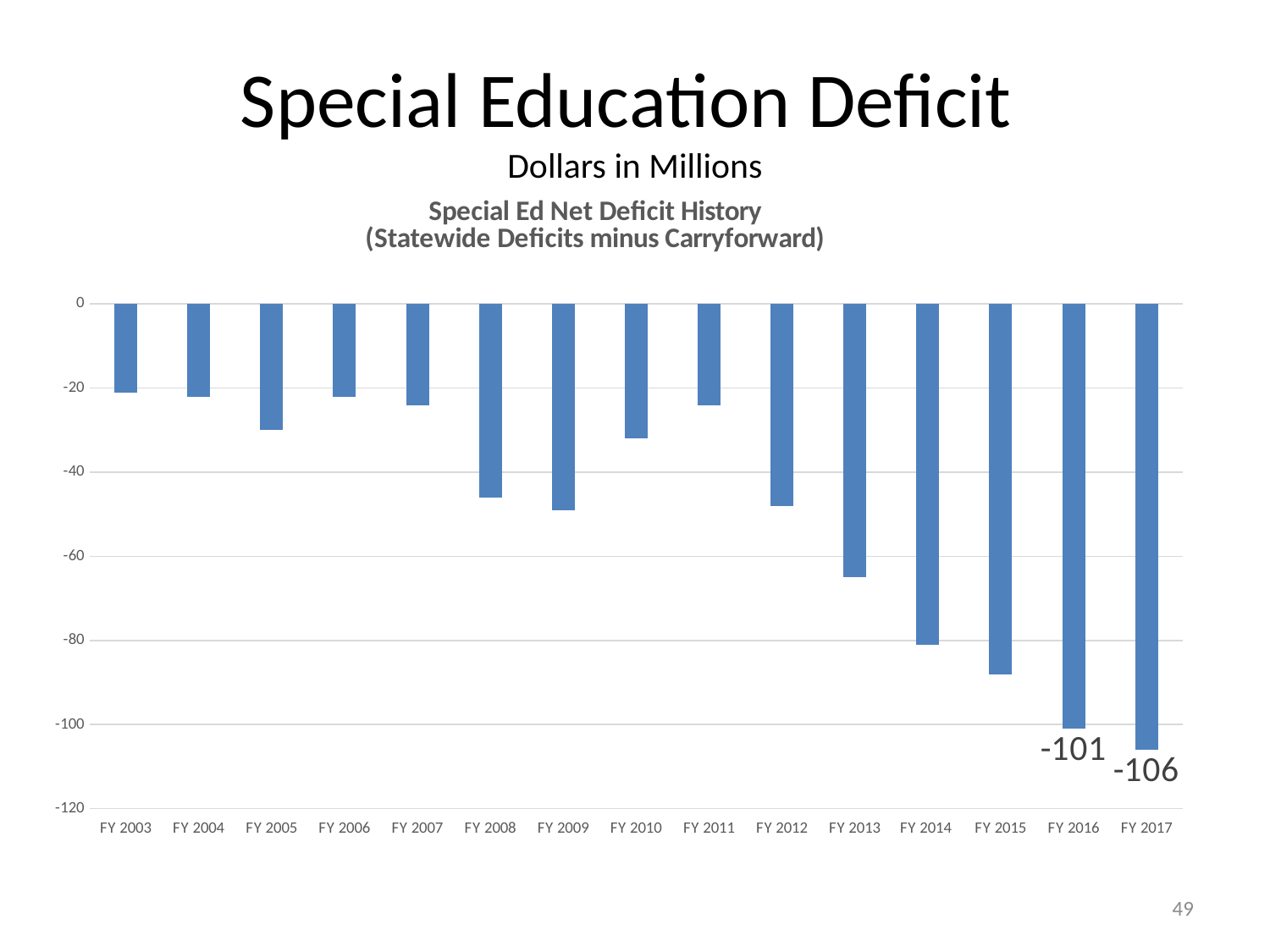
Do the values generally rise or fall from FY 2003 to FY 2017? Fall Is the value for FY 2015 greater or less than -80? less What kind of chart is shown on the slide? Bar chart Is the value for FY 2003 greater or less than -40? greater How many fiscal years are shown on the x axis? 15 What is the value for FY 2017? -106 What is the value for FY 2016? -101 Is the value for FY 2013 greater or less than -60? less Which is larger, the value for FY 2016 or the value for FY 2017? FY 2016 Which fiscal year has the lowest (most negative) value? FY 2017 What is the difference between the values for FY 2016 and FY 2017? 5 In what units are the values on the chart expressed? Dollars in Millions